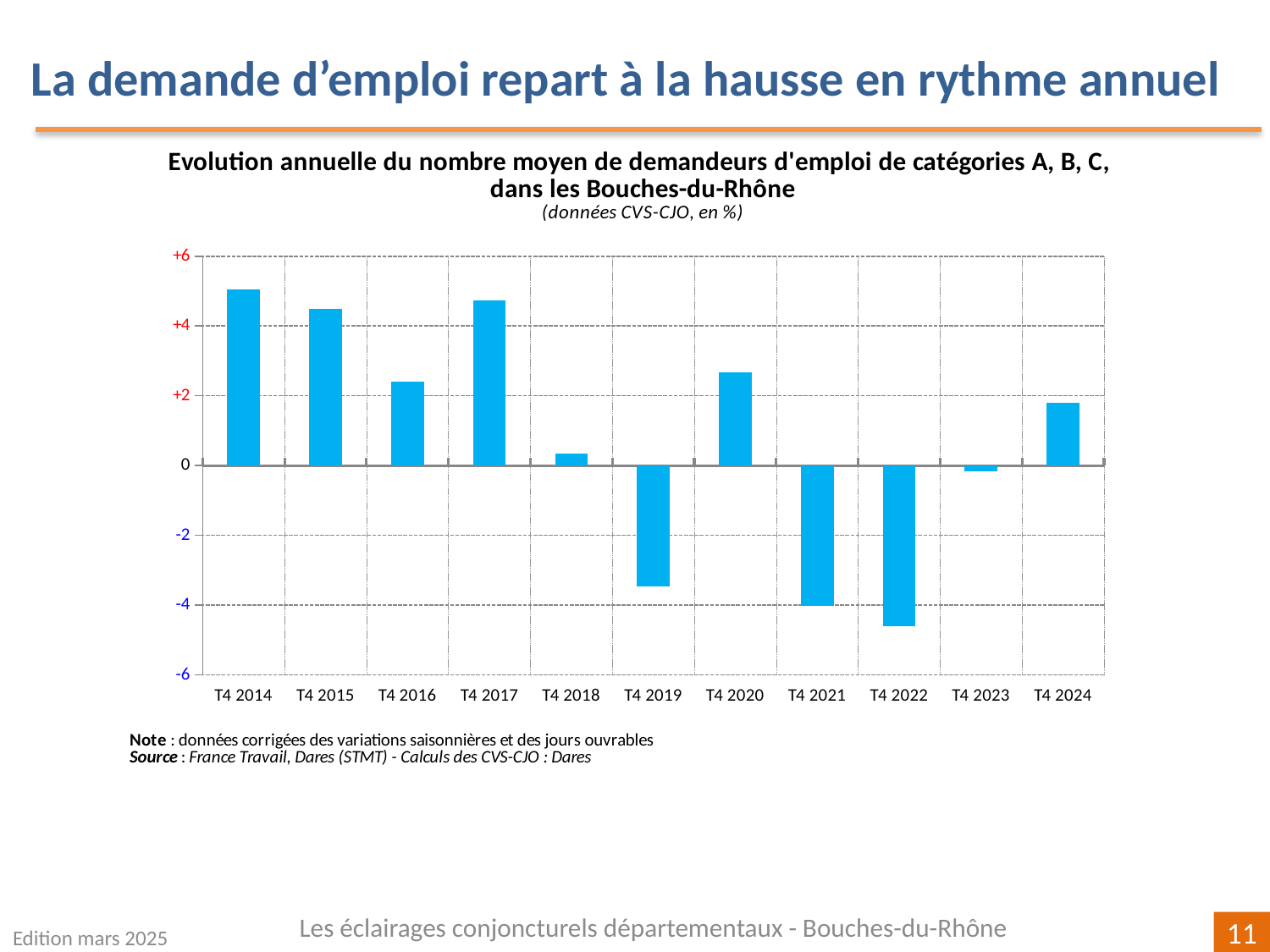
Which is larger, the value for T4 2020 or the value for T4 2018? T4 2020 Is the value for T4 2024 greater or less than +2? less Which is larger, the value for T4 2015 or the value for T4 2016? T4 2015 Which département does the chart title say the data refer to? Bouches-du-Rhône Which period has the highest value? T4 2014 How many periods (categories) are plotted on the x axis? 11 Is the value for T4 2014 greater or less than +4? greater In what unit are the data expressed, according to the chart subtitle? % Which period has the lowest value? T4 2022 Is the value for T4 2022 greater or less than -4? less What kind of chart is shown on the slide? bar chart